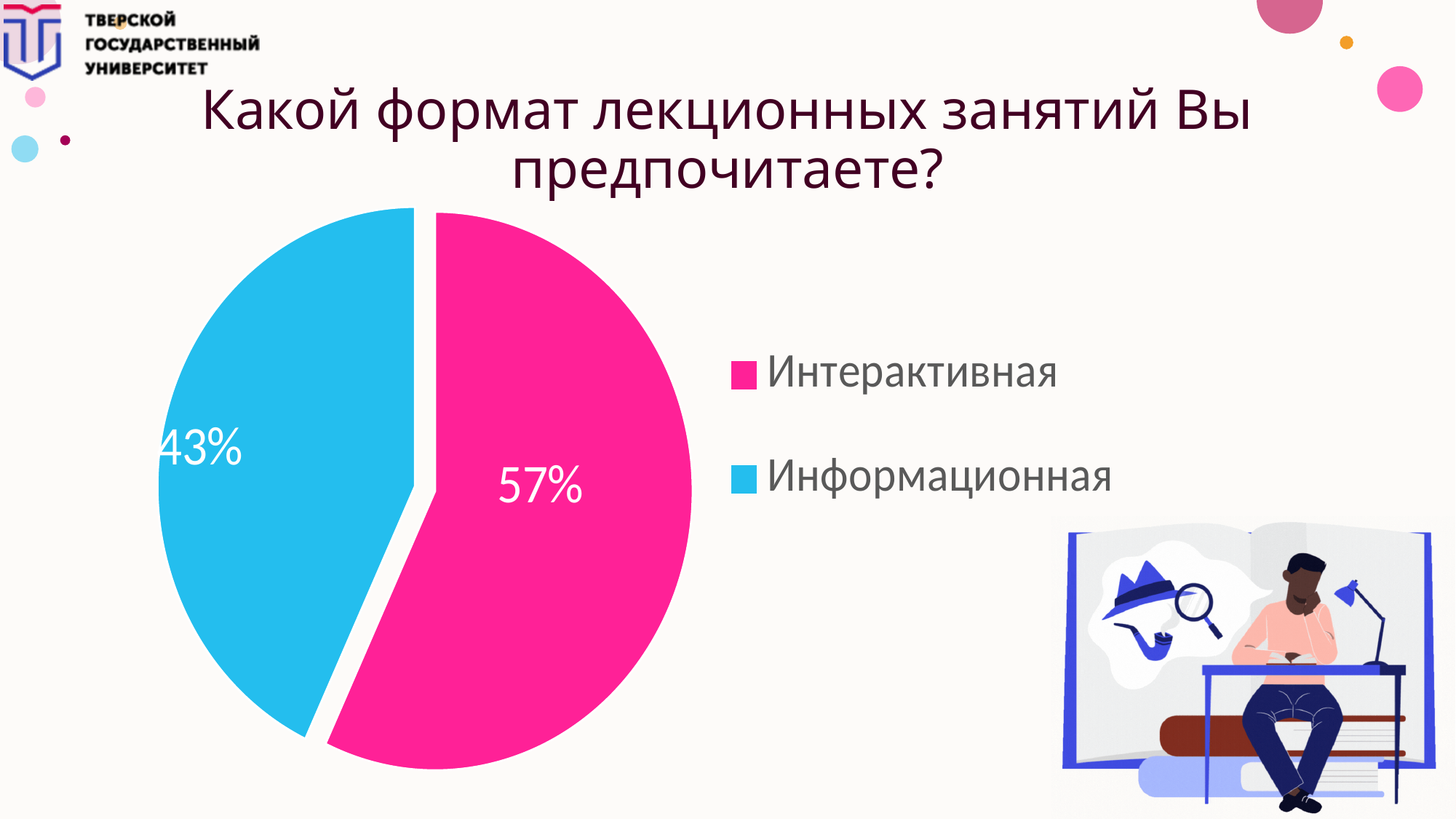
Which lecture format has the smallest share in the pie chart? Информационная Which slice is larger: Интерактивная or Информационная? Интерактивная How many entries does the legend list? 2 What is the title of the chart on the slide? Какой формат лекционных занятий Вы предпочитаете? What percentage of the pie chart corresponds to Информационная? 43% How many slices does the pie chart have? 2 What type of chart is shown on the slide? Pie chart What colour is the Информационная slice in the pie chart? Blue What is the share of the pie taken by the Информационная slice? 43% What is the difference in percentage points between the Интерактивная and Информационная slices? 14 What percentage of the pie chart corresponds to Интерактивная? 57% Which lecture format has the largest share in the pie chart? Интерактивная